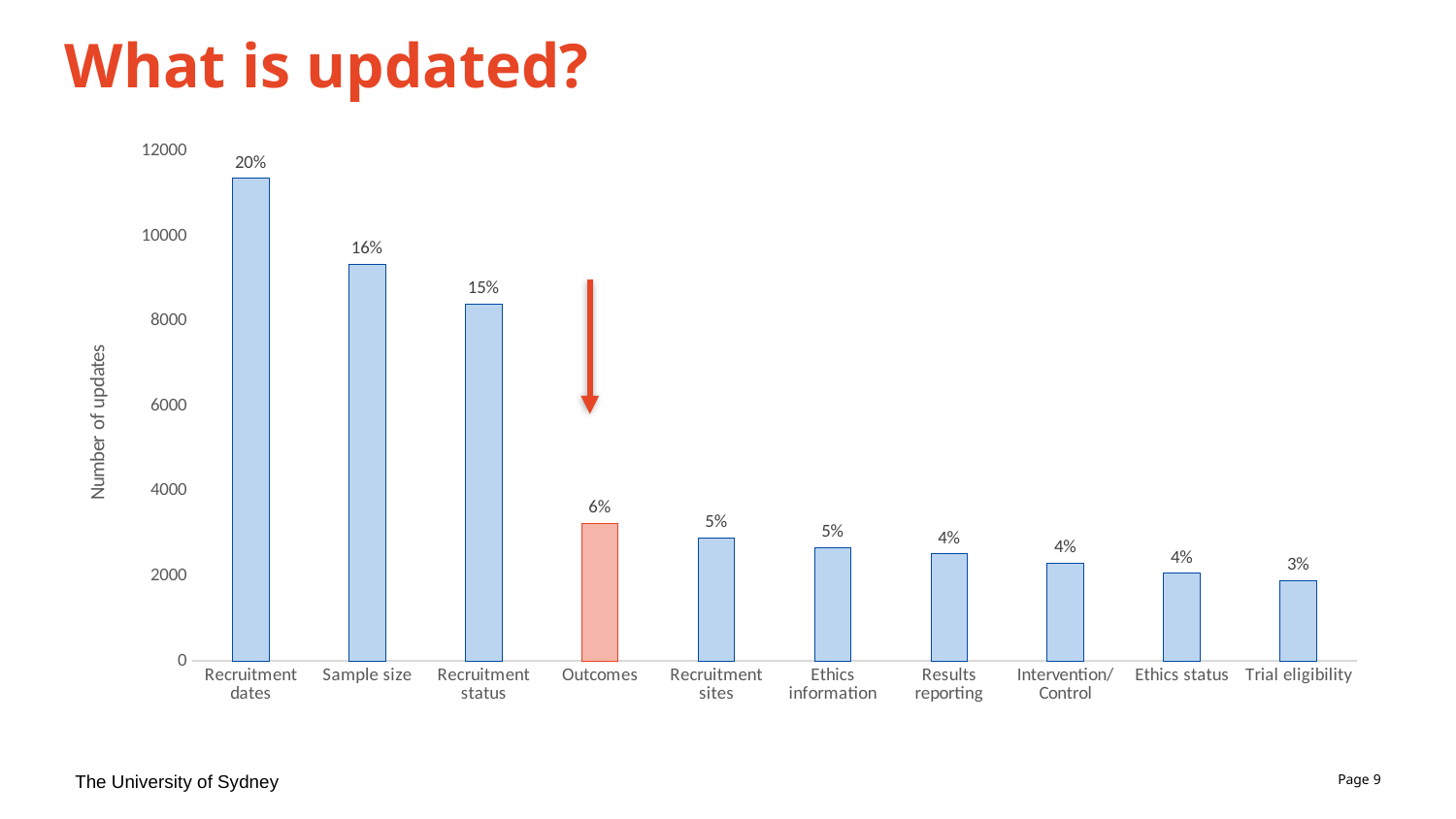
What percentage label is shown on the bar for Trial eligibility? 3% What percentage label is shown on the bar for Recruitment dates? 20% Which has a larger number of updates, Recruitment status or Outcomes? Recruitment status Is the number of updates for Outcomes greater or less than 4000? less Which category has the highest number of updates? Recruitment dates Which category has the lowest number of updates? Trial eligibility How many categories are shown on the x axis? 10 What is the difference in percentage points between the labels for Recruitment dates and Sample size? 4 What kind of chart is shown on the slide? Bar chart Which bar is highlighted in a different colour (orange) from the others? Outcomes Is the number of updates for Recruitment dates greater or less than 10000? greater What percentage label is shown on the bar for Outcomes? 6%